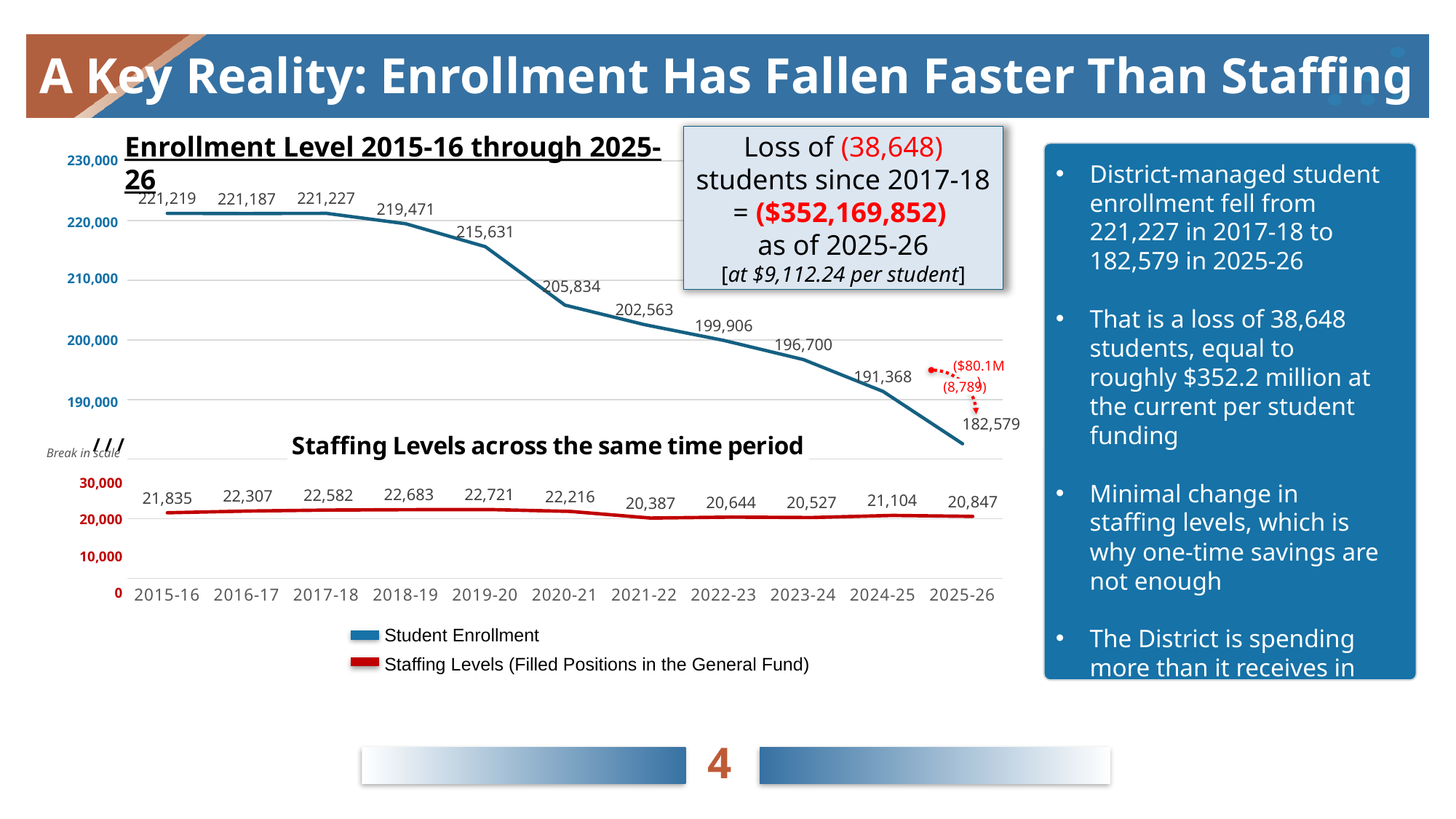
How many series does the legend list? 2 What was the Staffing Levels value for 2015-16? 21,835 What was the Staffing Levels value for 2021-22? 20,387 Which is larger: Student Enrollment in 2019-20 or in 2022-23? 2019-20 What is the difference between Student Enrollment in 2017-18 and in 2025-26? 38,648 How many years are plotted on the x axis? 11 What was the Student Enrollment value for 2025-26? 182,579 Does Student Enrollment rise or fall from 2017-18 to 2025-26? fall In which year was Student Enrollment lowest? 2025-26 What was the Student Enrollment value for 2020-21? 205,834 In which year was the Staffing Levels value lowest? 2021-22 What is the difference between Staffing Levels in 2015-16 and in 2025-26? 988